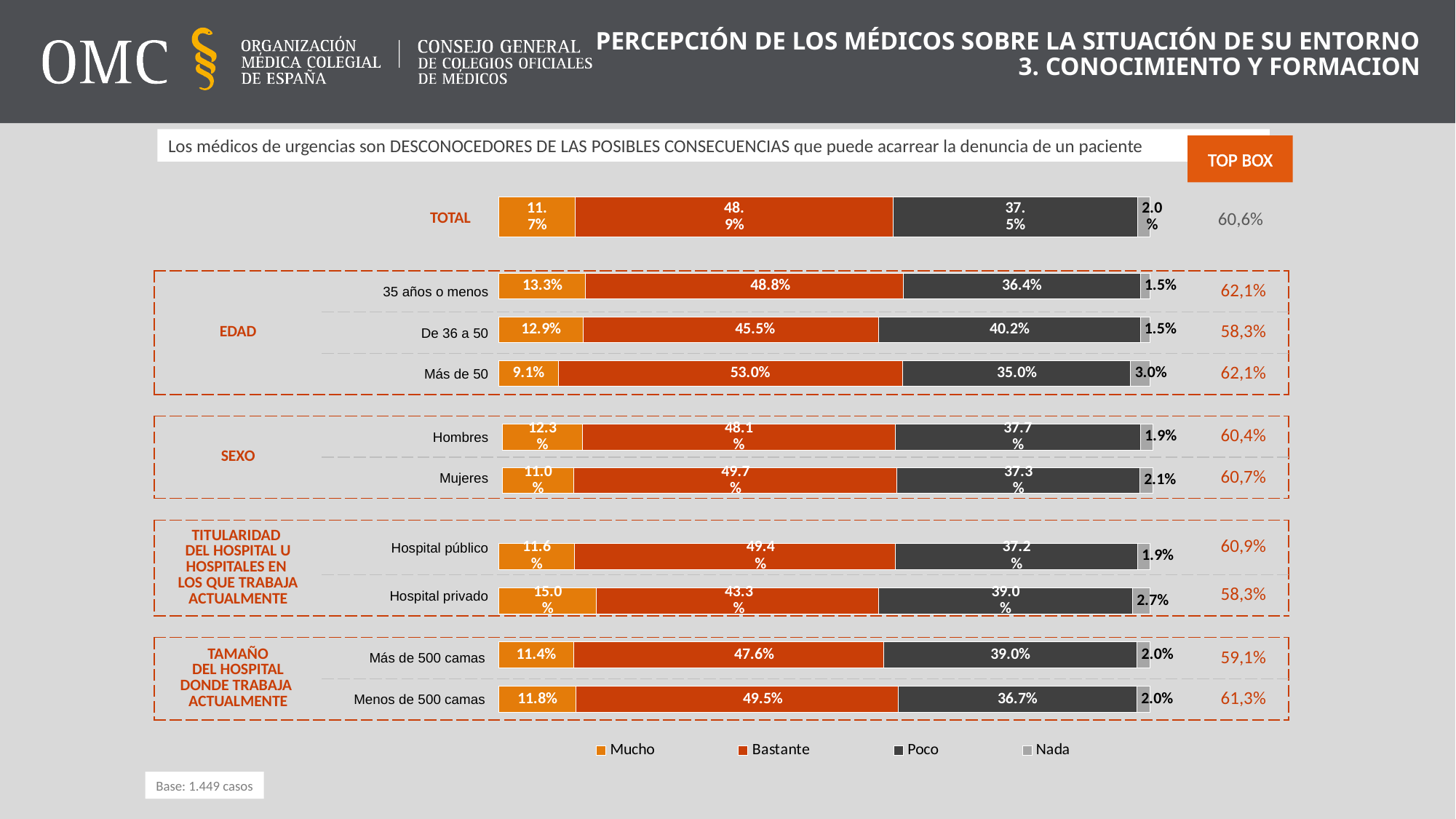
What is the 'Poco' value for 'De 36 a 50'? 40.2% Which category has the lowest 'Mucho' value? Más de 50 What kind of chart is shown on the slide? Stacked bar chart What is the difference between the 'Mucho' values for 'Hospital privado' and 'Hospital público'? 3.4% What is the 'Bastante' value for the TOTAL bar? 48.9% What is the 'Mucho' value for 'Hospital privado'? 15.0% How many series does the legend list? 4 Which is larger, the 'Poco' value for 'Más de 500 camas' or for 'Menos de 500 camas'? Más de 500 camas Which category has the highest 'Bastante' value? Más de 50 What is the base (number of cases) shown on the slide? 1.449 casos What is the TOP BOX value for '35 años o menos'? 62,1% What is the 'Nada' value for 'Más de 50'? 3.0%